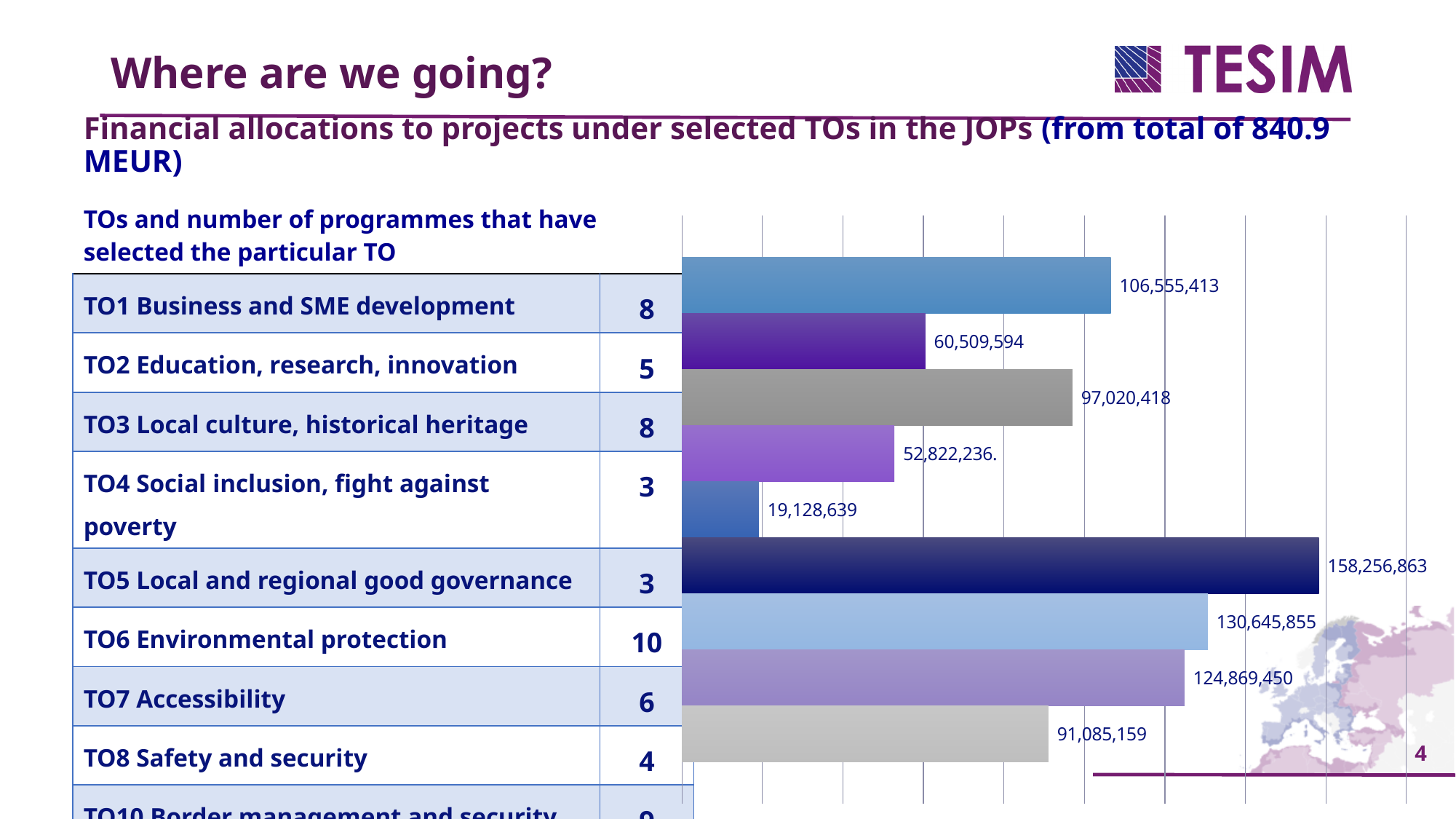
What value is labelled on the third bar from the top? 97,020,418 How many bars does the chart contain? 9 What value is labelled on the topmost bar of the chart? 106,555,413 Which is larger, the bar labelled 124,869,450 or the bar labelled 130,645,855? 130,645,855 What is the difference between the topmost bar (106,555,413) and the third bar from the top (97,020,418)? 9,534,995 What kind of chart is shown on the slide? bar chart What value is labelled on the second bar from the top? 60,509,594 What is the value shown on the shortest bar in the chart? 19,128,639 What value is labelled on the bottom bar of the chart? 91,085,159 What is the difference between the longest bar (158,256,863) and the second-longest bar (130,645,855)? 27,611,008 What is the value shown on the longest bar in the chart? 158,256,863 According to the slide heading, what is the total amount in MEUR from which the financial allocations are drawn? 840.9 MEUR